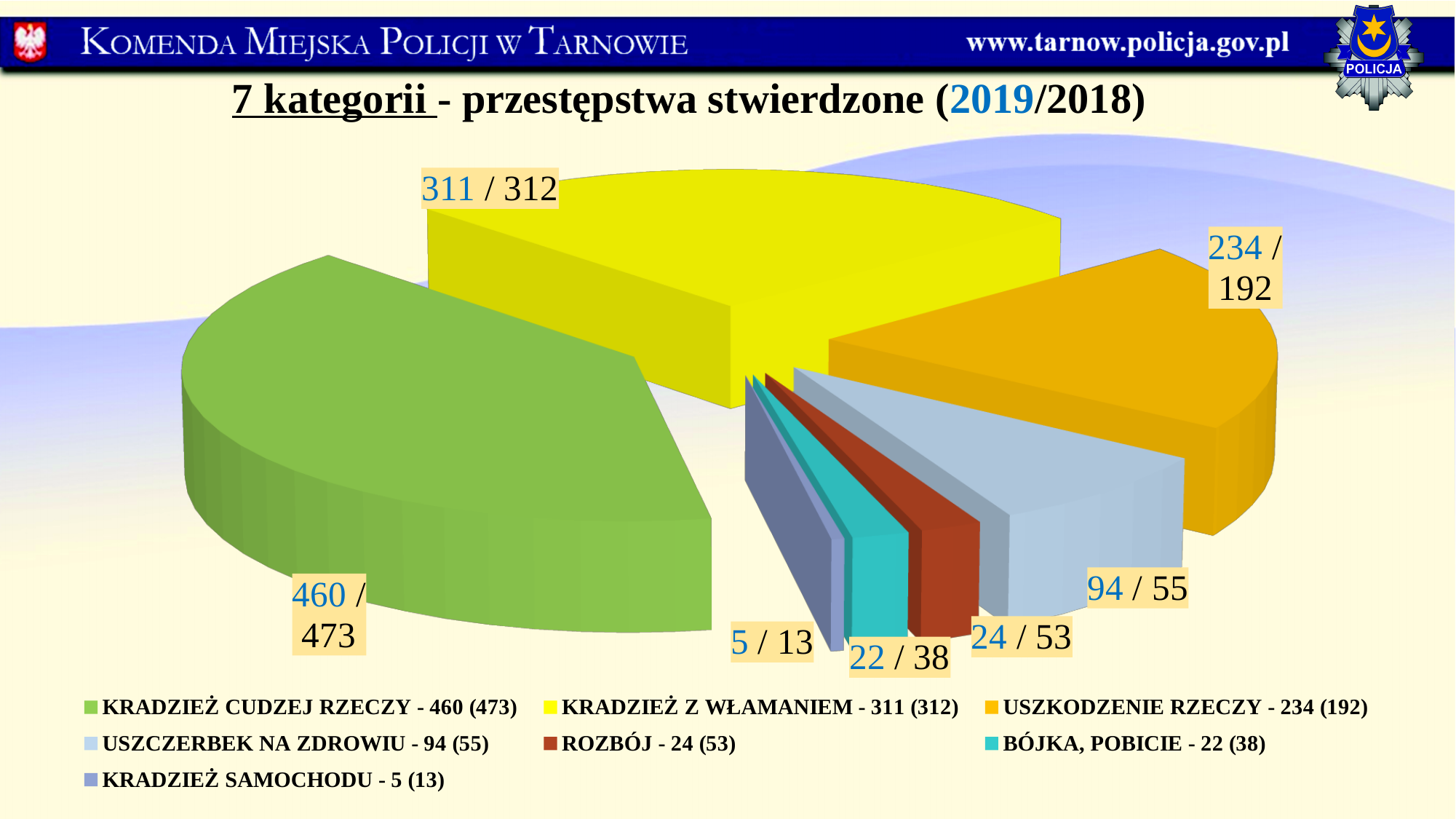
How many categories does the pie chart show? 7 Which category has the smallest 2019 value? KRADZIEŻ SAMOCHODU By how much did USZKODZENIE RZECZY increase from 2018 to 2019? 42 Which category has the largest 2019 value? KRADZIEŻ CUDZEJ RZECZY Which is larger, the 2019 value for USZCZERBEK NA ZDROWIU or the 2019 value for ROZBÓJ? USZCZERBEK NA ZDROWIU What is the 2018 value for ROZBÓJ? 53 What is the 2019 value for KRADZIEŻ CUDZEJ RZECZY? 460 What is the 2019 value for USZKODZENIE RZECZY? 234 What is the 2018 value for KRADZIEŻ SAMOCHODU? 13 What is the difference between the 2019 values for KRADZIEŻ CUDZEJ RZECZY and KRADZIEŻ Z WŁAMANIEM? 149 What share of the total 2019 value does KRADZIEŻ CUDZEJ RZECZY represent? 40% What kind of chart is shown on the slide? pie chart